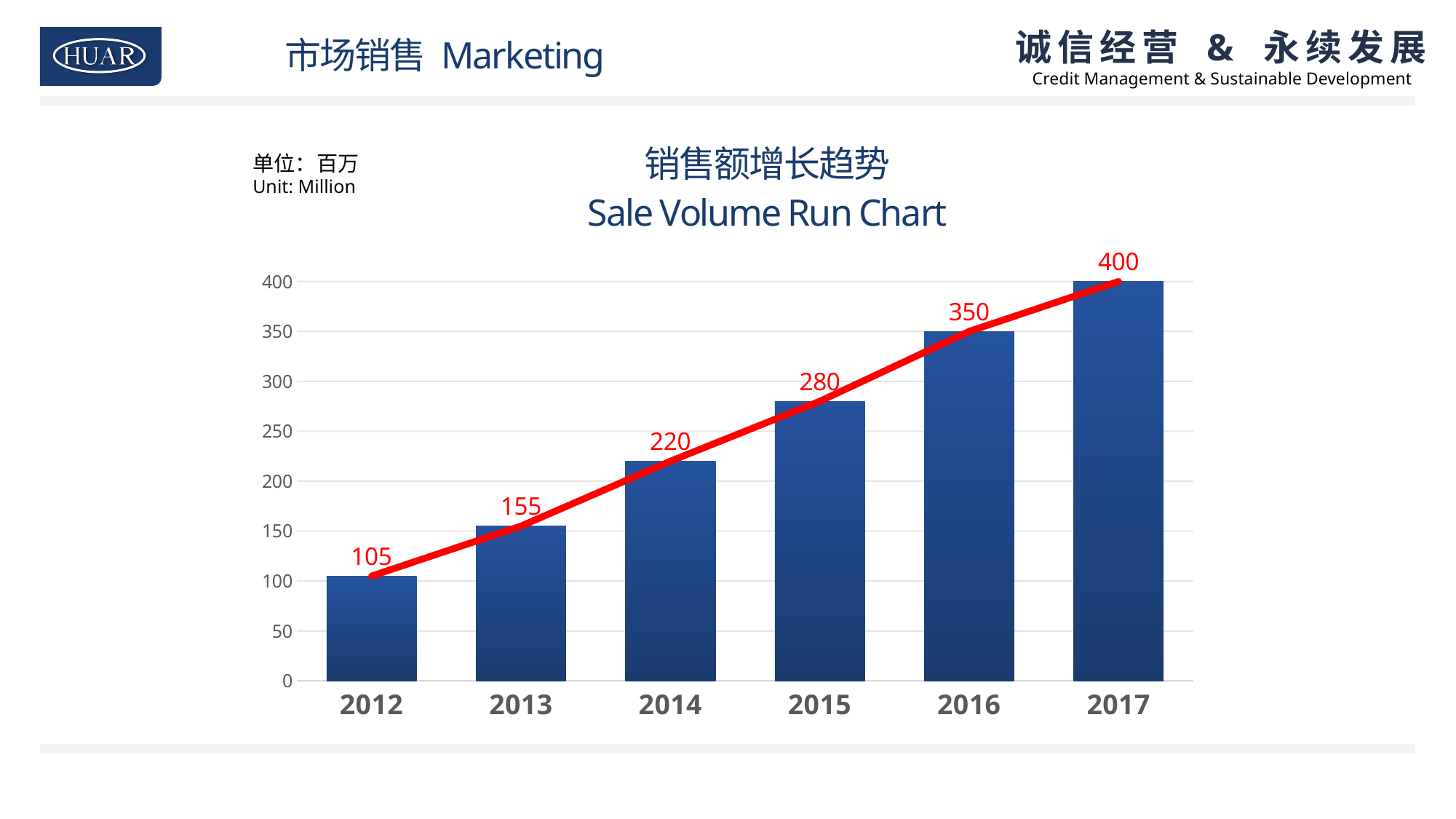
Do the sale volumes rise or fall from 2012 to 2017? Rise Which year has the highest sale volume? 2017 What unit is stated for the values in the chart? Million What is the difference between the sale volume in 2015 and in 2014? 60 How many years are shown on the x axis? 6 What is the sale volume for 2014? 220 What kind of chart is this? Bar chart with a line Which year has the lowest sale volume? 2012 What is the difference between the sale volume in 2017 and in 2012? 295 Which year has a larger sale volume, 2013 or 2015? 2015 What is the sale volume for 2016? 350 What is the sale volume for 2012? 105